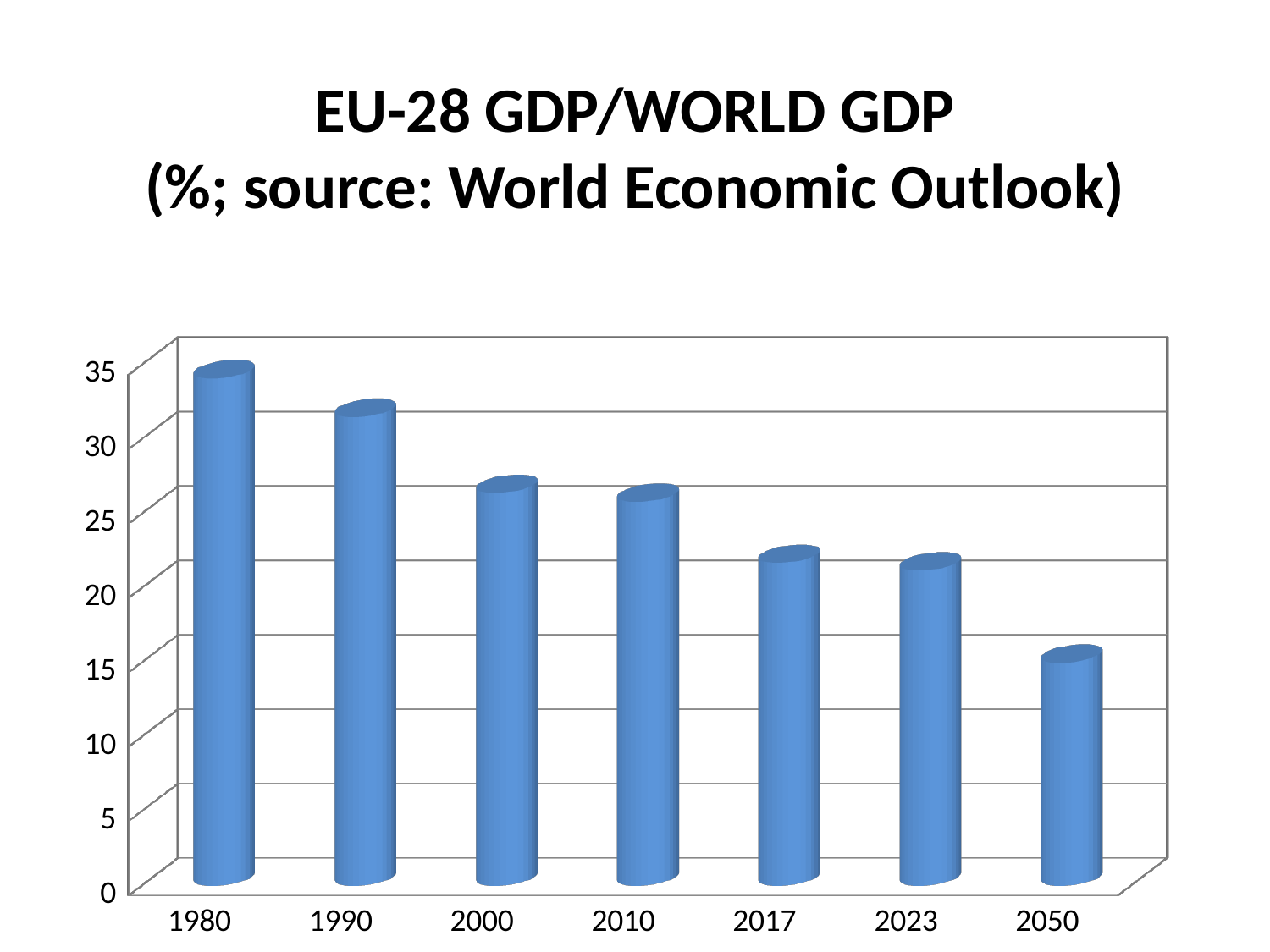
Which year has the highest EU-28 GDP share of world GDP? 1980 Which is larger, the value for 2023 or the value for 2050? 2023 Is the value for 2050 greater or less than 20? less Which year has the lowest EU-28 GDP share of world GDP? 2050 Do the values rise or fall from 1980 to 2050? fall Is the value for 1980 greater or less than 30? greater Is the value for 2017 greater or less than 25? less What is the source cited in the chart title? World Economic Outlook How many years are shown on the x axis of the chart? 7 Which is larger, the value for 1990 or the value for 2017? 1990 What kind of chart is shown on the slide? bar chart